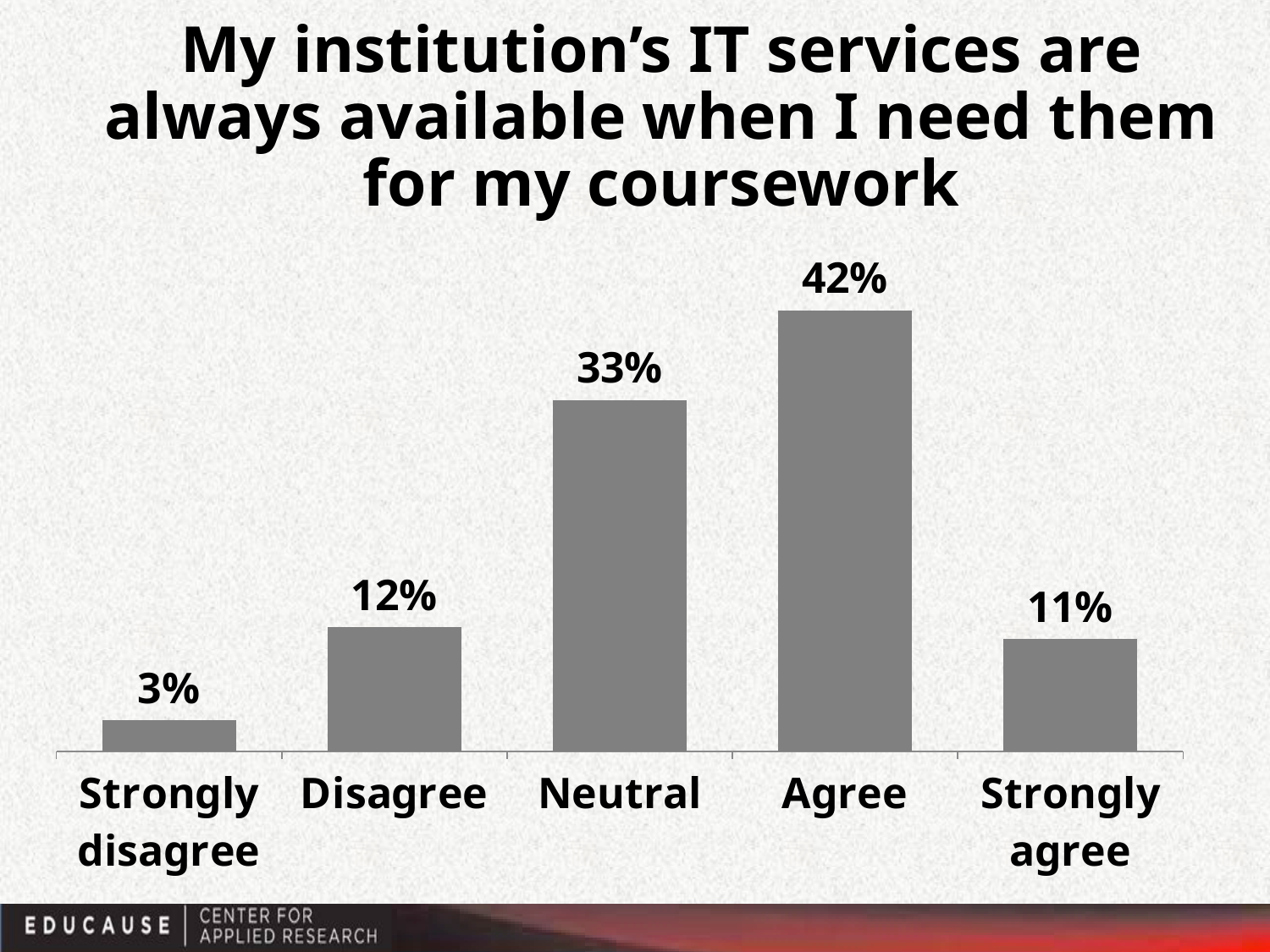
What is the title of the chart? My institution's IT services are always available when I need them for my coursework How many categories are shown on the x axis? 5 Which category has the lowest value? Strongly disagree Which category has the highest value? Agree What percentage of respondents chose Agree? 42% What kind of chart is shown on the slide? Bar chart What is the difference between the Agree and Neutral values? 9% What percentage of respondents chose Neutral? 33% What is the value for Strongly agree? 11% What is the difference between the Disagree and Strongly agree values? 1% Which is larger, the value for Disagree or the value for Neutral? Neutral What is the value for Strongly disagree? 3%